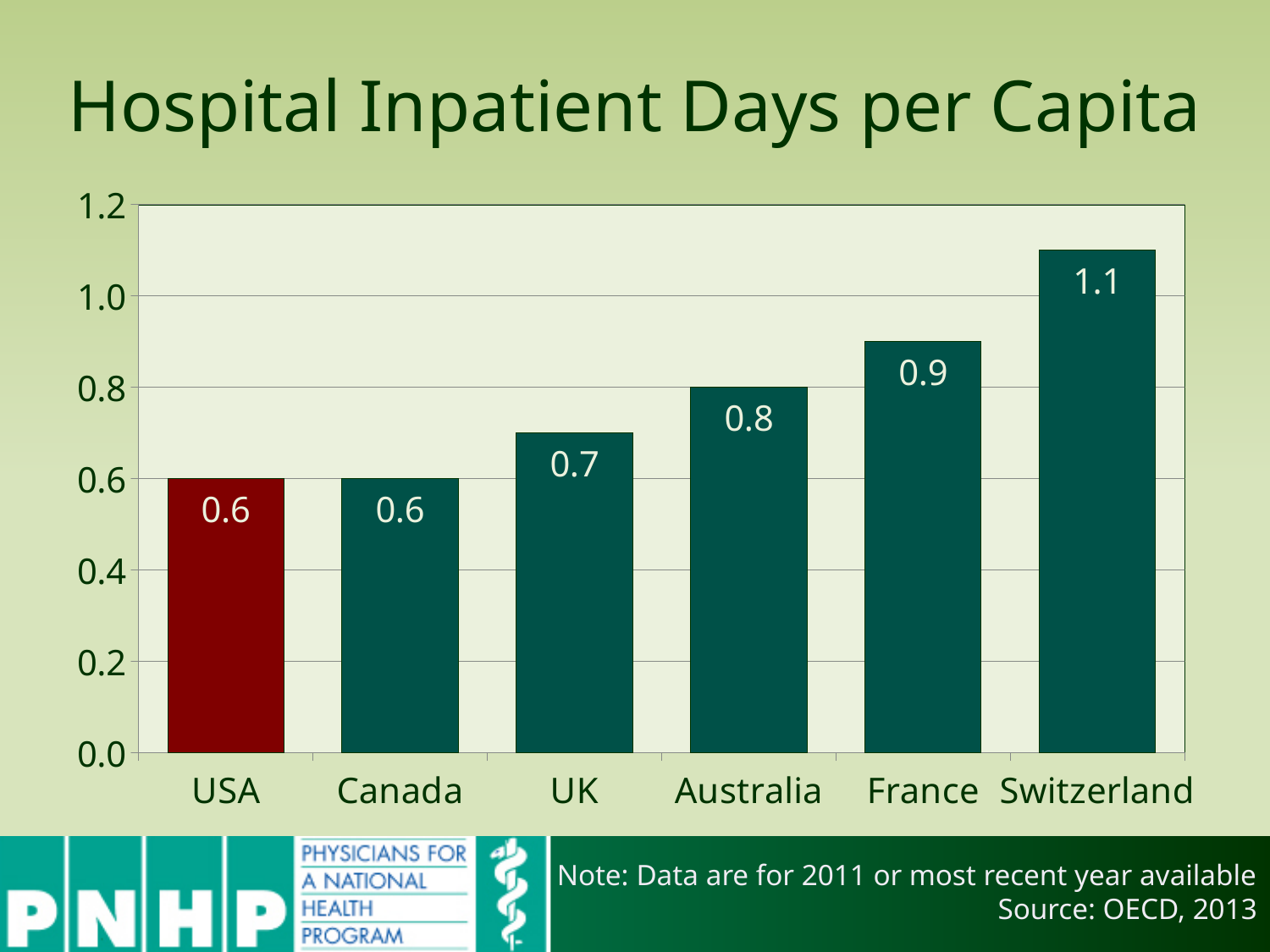
Which is larger, the value for France or the value for Canada? France What is the value for Switzerland? 1.1 What is the difference between the values for France and the UK? 0.2 What is the value for Australia? 0.8 Do the values rise or fall from left to right across the countries? rise What is the value for the UK? 0.7 Is the value for Switzerland greater or less than 1.0? greater Which country's bar is coloured differently from the others? USA What is the difference between the values for Switzerland and the USA? 0.5 Which country has the highest hospital inpatient days per capita? Switzerland What kind of chart is shown on the slide? bar chart How many countries are shown in the chart? 6